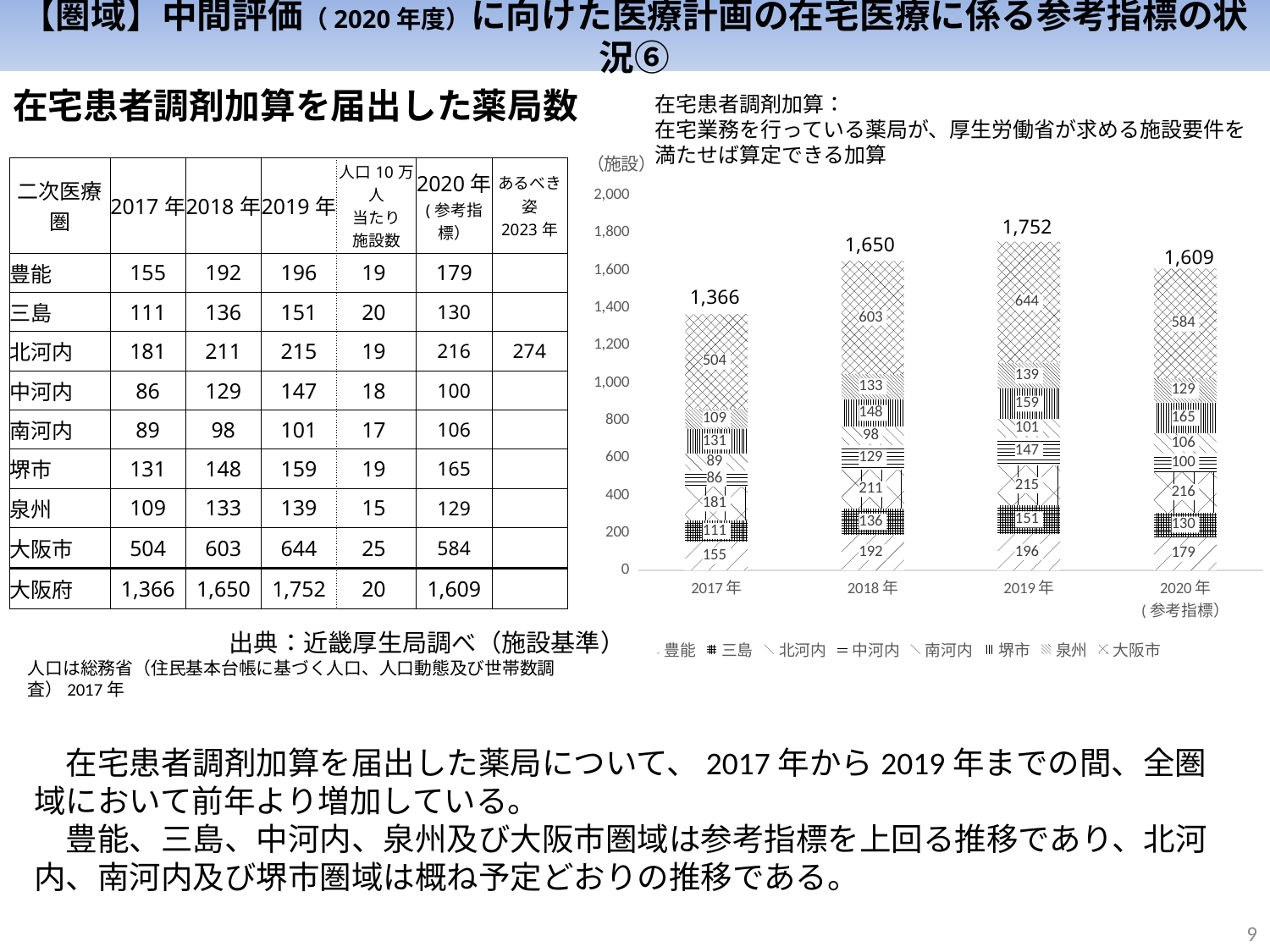
What is the total of the stacked bar for 2019年? 1,752 Which year has the lowest stacked bar total? 2017年 What is the value for 北河内 in 2020年(参考指標)? 216 What is the total of the stacked bar for 2017年? 1,366 Which year has the highest stacked bar total? 2019年 Which is larger, the 堺市 value in 2018年 or the 堺市 value in 2019年? 2019年 How many bars (years) are plotted in the chart? 4 What kind of chart is shown on the slide? stacked bar chart What is the value for 大阪市 in 2018年? 603 What is the value for 豊能 in 2019年? 196 What is the difference between the 大阪市 values for 2019年 and 2017年? 140 How many series does the chart legend list? 8